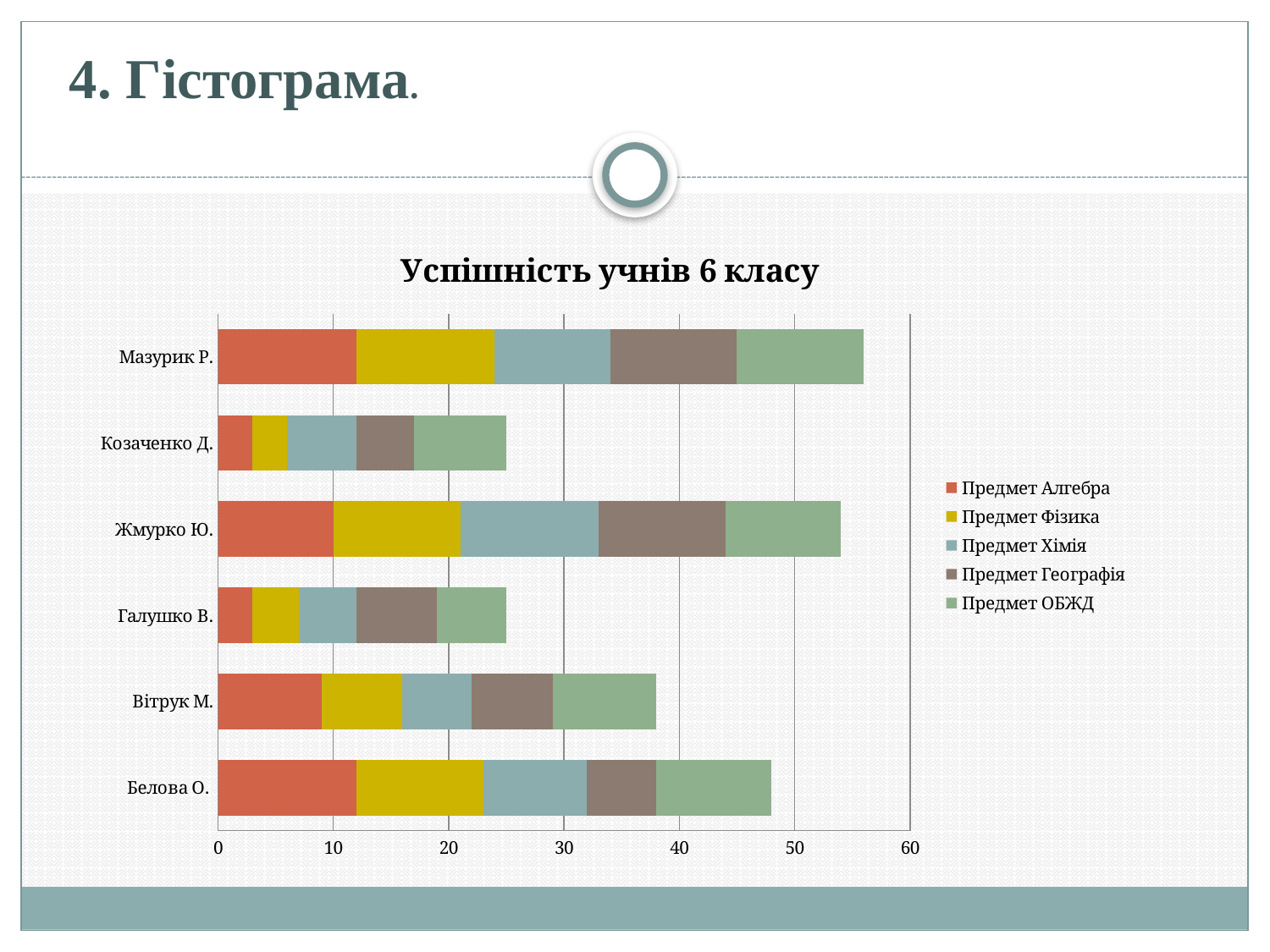
Which has the longer total bar, Белова О. or Галушко В.? Белова О. How many series does the legend list? 5 Which series is shown in red on the chart? Предмет Алгебра Is the total bar length for Вітрук М. greater or less than 40? less What kind of chart is shown on the slide? stacked bar chart Is the total bar length for Мазурик Р. greater or less than 50? greater How many students (categories) are shown on the chart? 6 What is the title of the chart? Успішність учнів 6 класу Is the total bar length for Жмурко Ю. greater or less than 50? greater Which has the longer total bar, Мазурик Р. or Вітрук М.? Мазурик Р.